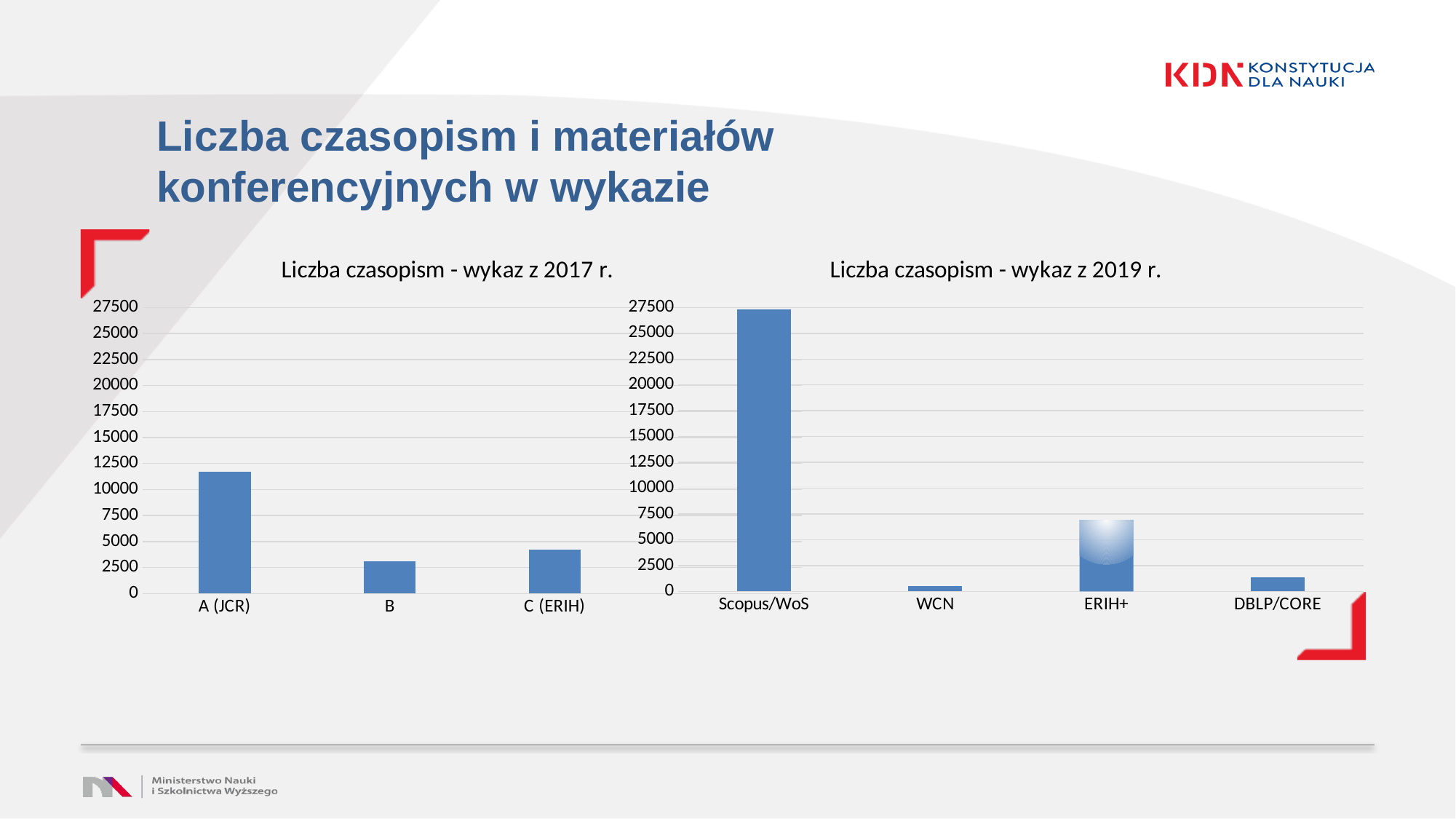
What type of chart is the chart titled "Liczba czasopism - wykaz z 2019 r."? bar chart In the chart titled "Liczba czasopism - wykaz z 2017 r.", is the value for B greater or less than 5000? less In the chart titled "Liczba czasopism - wykaz z 2017 r.", how many categories are shown? 3 In the chart titled "Liczba czasopism - wykaz z 2017 r.", is the value for A (JCR) greater or less than 10000? greater In the chart titled "Liczba czasopism - wykaz z 2019 r.", which is larger, ERIH+ or DBLP/CORE? ERIH+ In the chart titled "Liczba czasopism - wykaz z 2019 r.", which category has the lowest value? WCN In the chart titled "Liczba czasopism - wykaz z 2019 r.", which category has the highest value? Scopus/WoS In the chart titled "Liczba czasopism - wykaz z 2017 r.", which category has the highest value? A (JCR) In the chart titled "Liczba czasopism - wykaz z 2019 r.", is the value for DBLP/CORE greater or less than 2500? less In the chart titled "Liczba czasopism - wykaz z 2017 r.", which category has the lowest value? B